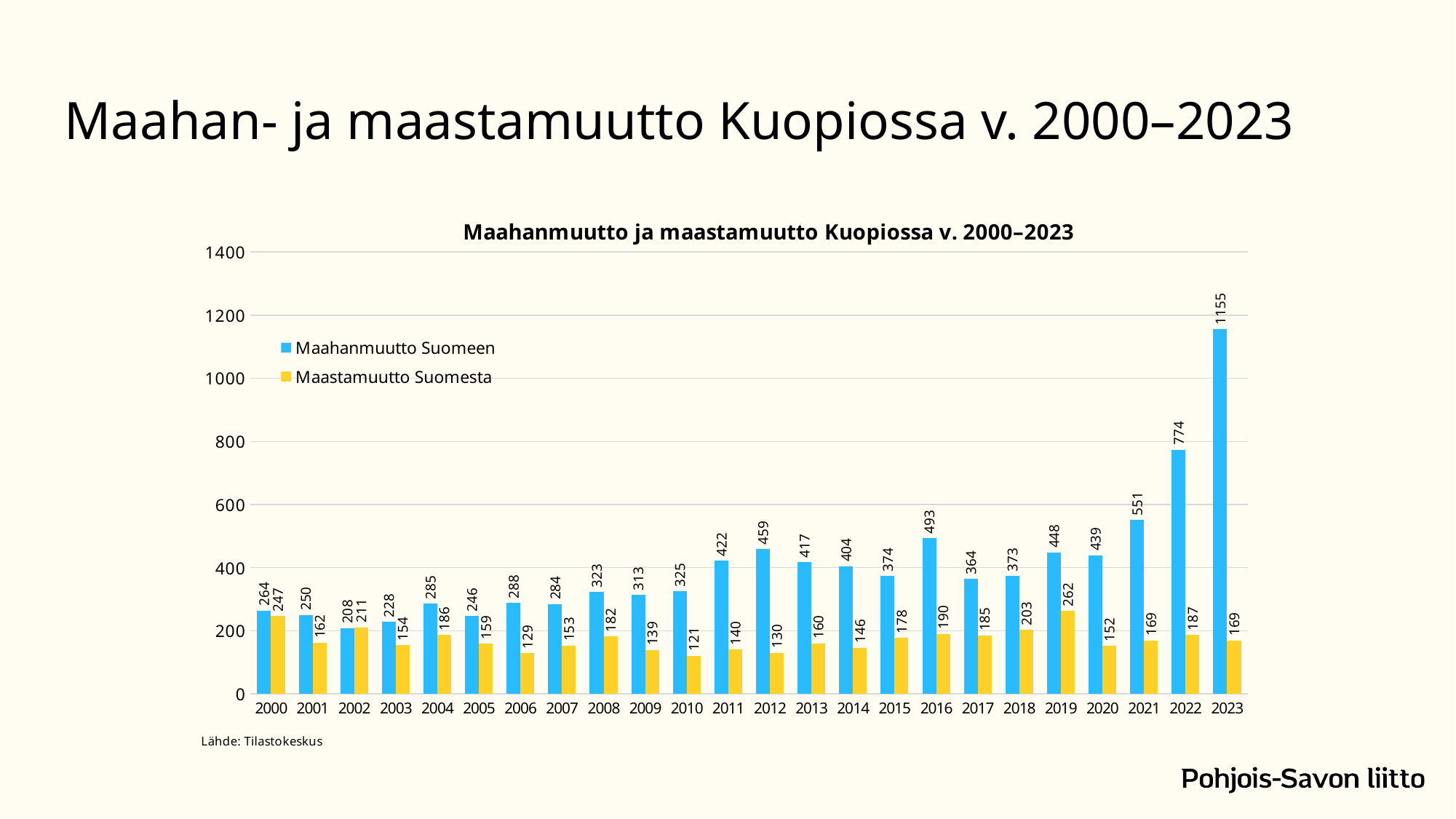
Which year has the lowest value for Maastamuutto Suomesta? 2010 What is the difference between Maahanmuutto Suomeen and Maastamuutto Suomesta in 2022? 587 Which is larger in 2002, Maahanmuutto Suomeen or Maastamuutto Suomesta? Maastamuutto Suomesta What is the source cited below the chart? Tilastokeskus How many series does the legend list? 2 What is the value for Maahanmuutto Suomeen in 2023? 1155 What kind of chart is shown on the slide? Bar chart Does the value for Maahanmuutto Suomeen rise or fall from 2020 to 2023? Rise What is the value for Maastamuutto Suomesta in 2019? 262 What is the value for Maahanmuutto Suomeen in 2010? 325 How many years are shown on the x axis? 24 Which year has the highest value for Maahanmuutto Suomeen? 2023